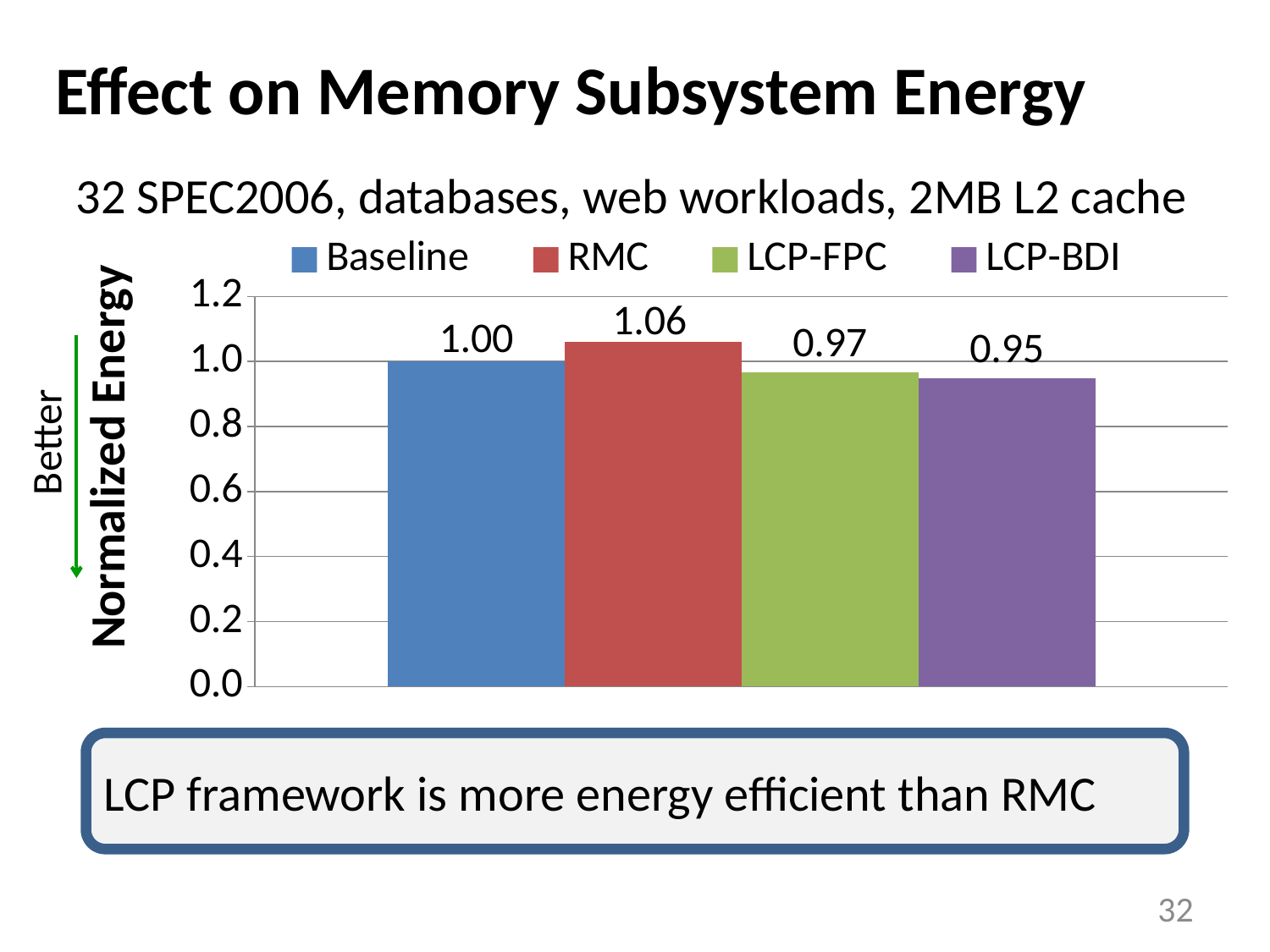
Which has a higher normalized energy, RMC or LCP-FPC? RMC What is the label of the y axis? Normalized Energy What is the normalized energy for Baseline? 1.00 What is the normalized energy for LCP-BDI? 0.95 What is the normalized energy for LCP-FPC? 0.97 What kind of chart is shown on the slide? Bar chart Which series has the highest normalized energy? RMC What is the difference in normalized energy between RMC and LCP-BDI? 0.11 How many series does the legend list? 4 What is the difference in normalized energy between Baseline and LCP-FPC? 0.03 Which series has the lowest normalized energy? LCP-BDI What is the normalized energy for RMC? 1.06